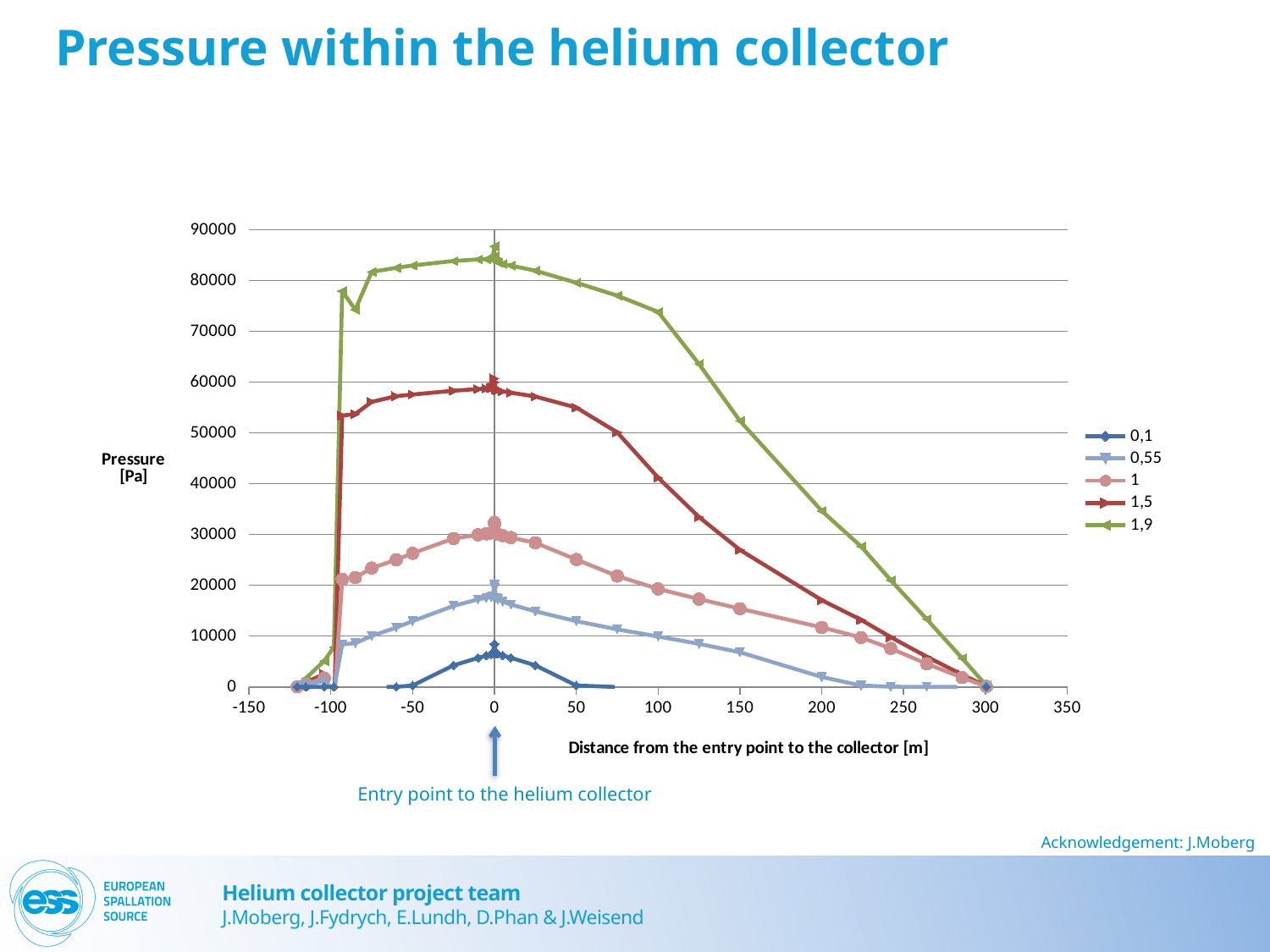
What is the label of the x axis? Distance from the entry point to the collector [m] Which series reaches the highest pressure? 1,9 What is the label of the y axis? Pressure [Pa] Which series has the lowest pressure at the entry point (distance 0)? 0,1 Is the pressure for series 1 at distance 0 greater or less than 40000? less How many series does the legend list? 5 Is the pressure for series 0,55 at distance 0 greater or less than 10000? greater Is the pressure for series 1,5 at distance 200 greater or less than 20000? less At distance 0, is the pressure for series 1,5 or series 1 higher? 1,5 Between distance 0 and 300, does the pressure for series 1,9 rise or fall? fall What kind of chart is shown on the slide? line chart